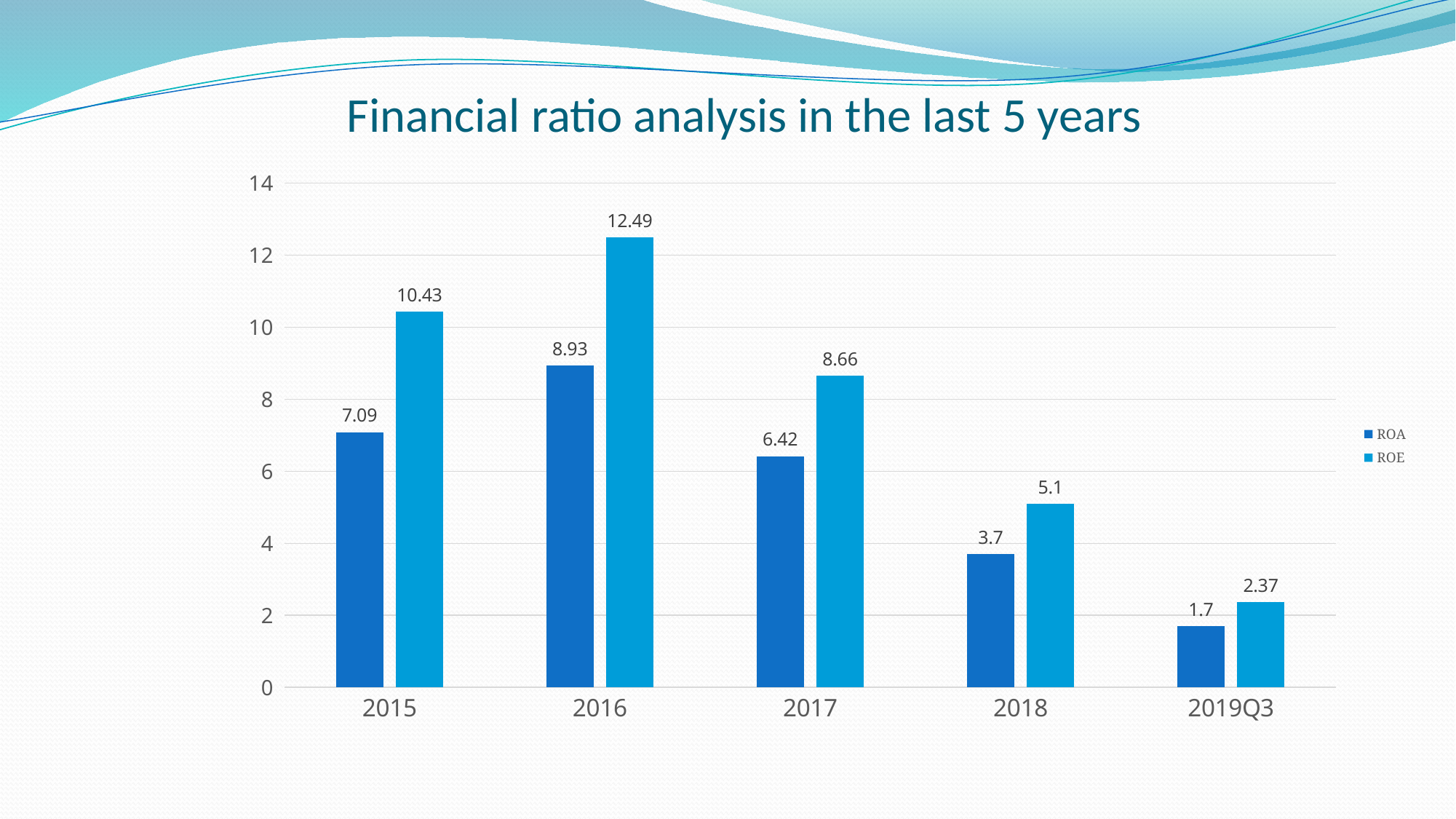
In which period is ROA lowest? 2019Q3 What kind of chart is shown on the slide? Bar chart What is the ROA value for 2019Q3? 1.7 What is the difference between ROE and ROA in 2015? 3.34 What is the ROE value for 2018? 5.1 How many series does the legend list? 2 Does ROA rise or fall from 2016 to 2019Q3? Fall Is the ROE value for 2016 greater or less than 12? greater How many periods are shown on the x axis? 5 Which is larger in 2017, ROA or ROE? ROE What is the ROA value for 2016? 8.93 In which year is ROE highest? 2016